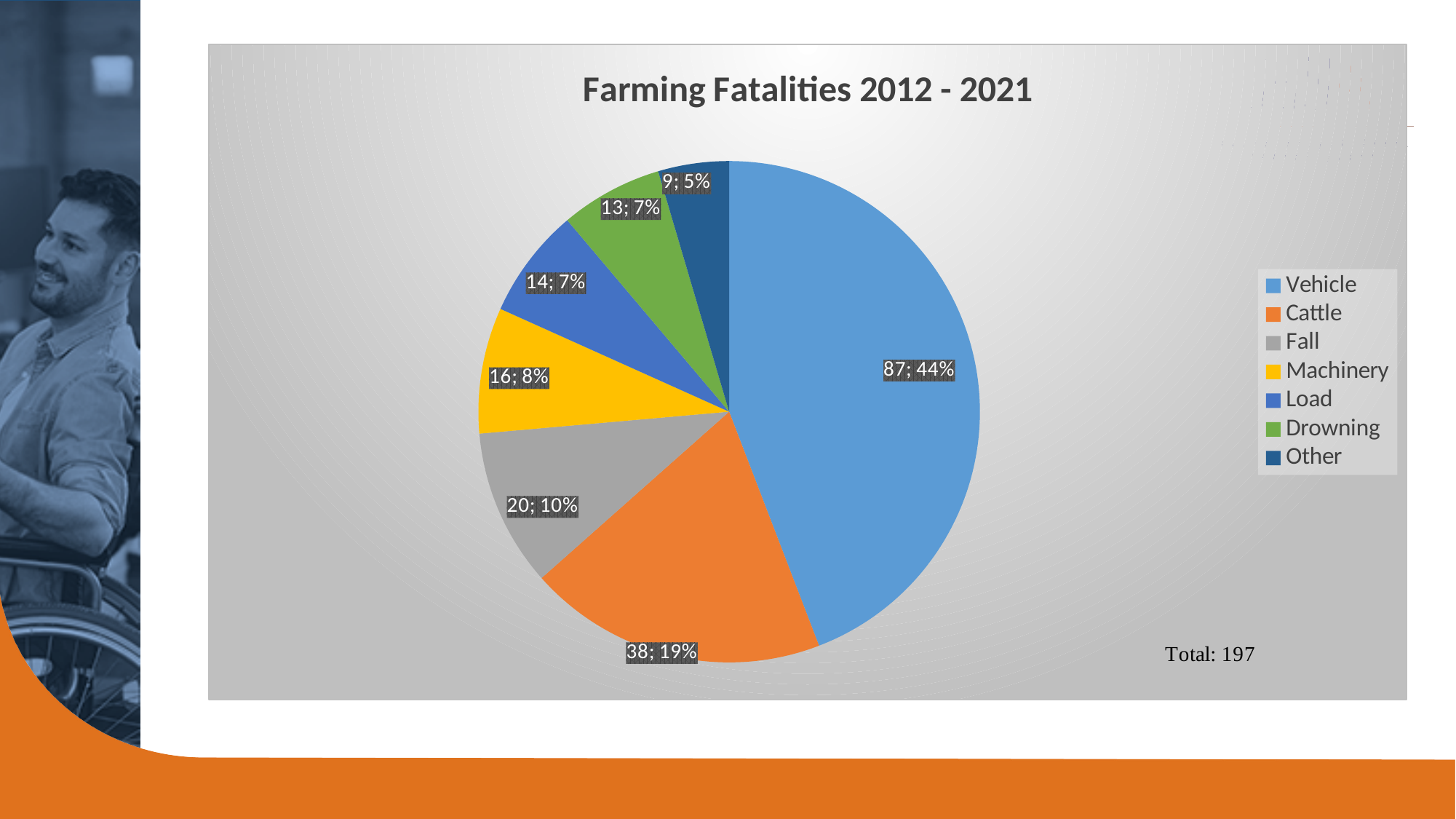
What is the title of the chart? Farming Fatalities 2012 - 2021 Which category has the largest slice? Vehicle What percentage share of fatalities is attributed to Cattle? 19% What percentage share of fatalities is attributed to Machinery? 8% How many fatalities are attributed to Fall? 20 What total number of fatalities is shown on the slide? 197 How many fatalities are attributed to Vehicle? 87 Which has more fatalities, Load or Drowning? Load Which category has the smallest slice? Other What kind of chart is shown on the slide? pie chart What is the difference between the Vehicle and Cattle fatality counts? 49 How many categories does the legend list? 7